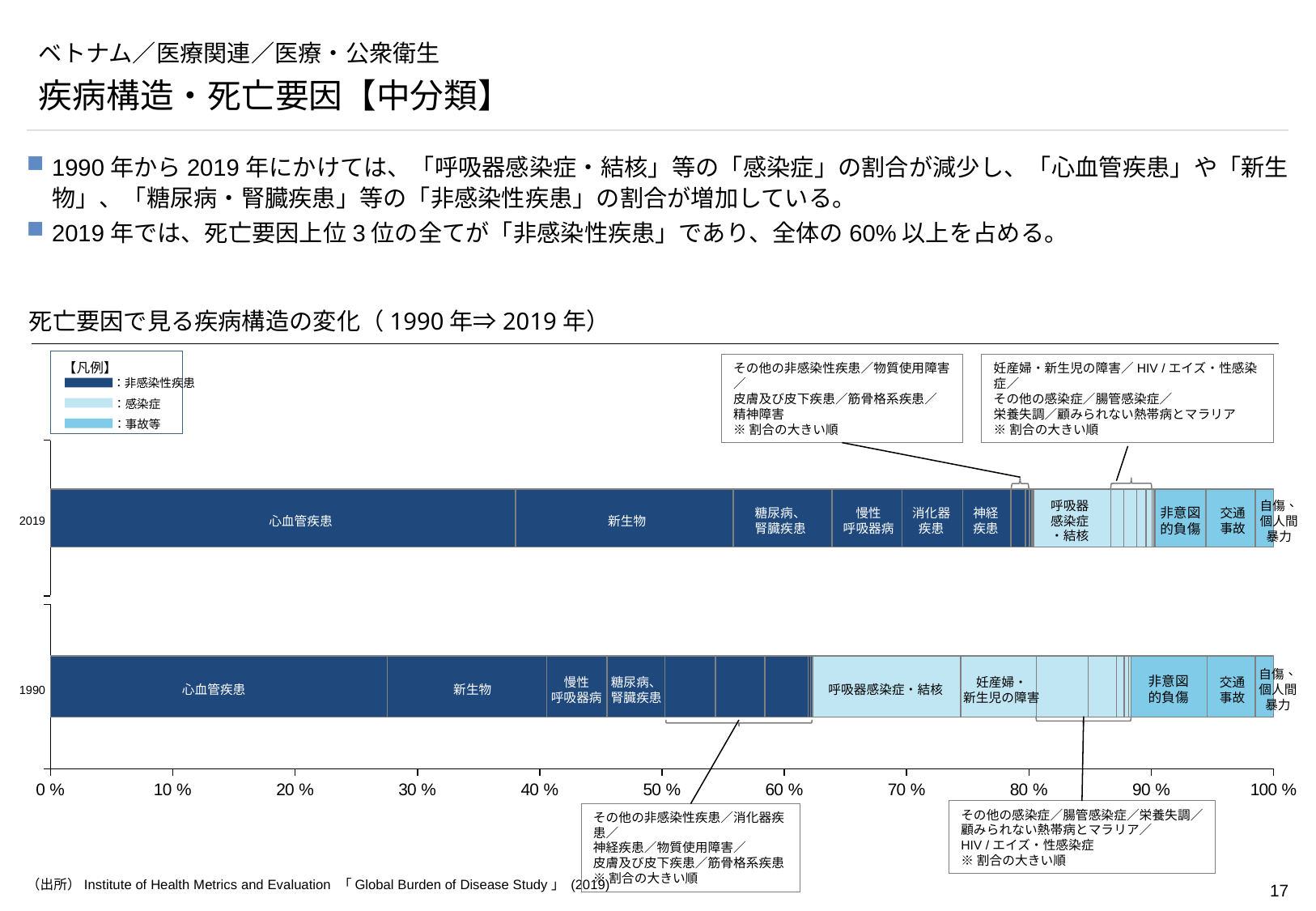
What kind of chart is shown on the slide? Stacked bar chart Which cause of death has the largest share in the 1990 bar? 心血管疾患 Is the share of 呼吸器感染症・結核 larger in 1990 or in 2019? 1990 Which legend category is shown in the darkest blue? 非感染性疾患 How many categories does the legend (凡例) list? 3 How many years (bars) are plotted in the chart? 2 Is the share of 心血管疾患 larger in 2019 or in 1990? 2019 Is the share of 心血管疾患 in 2019 greater or less than 30%? greater Is the combined share of 心血管疾患 and 新生物 in 2019 greater or less than 50%? greater Which cause of death has the largest share in the 2019 bar? 心血管疾患 From 1990 to 2019, does the share of 新生物 rise or fall? rise Which years are compared in the chart? 1990 and 2019